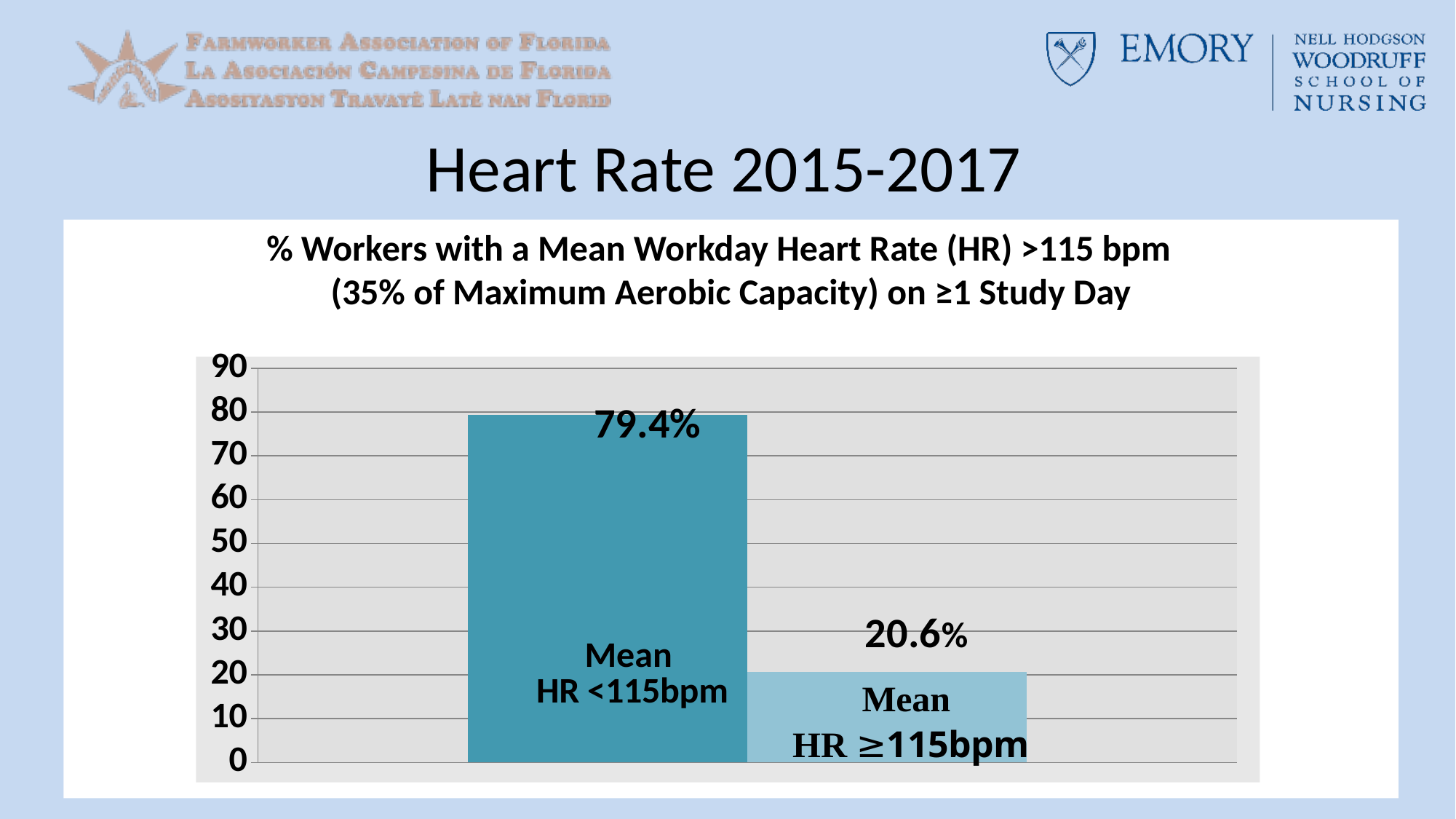
How many bars are shown in the chart? 2 What is the difference between the Mean HR <115bpm and Mean HR ≥115bpm values? 58.8% What is the title of the chart? % Workers with a Mean Workday Heart Rate (HR) >115 bpm (35% of Maximum Aerobic Capacity) on ≥1 Study Day What percentage of workers had a mean HR <115bpm? 79.4% Which category has the higher value? Mean HR <115bpm Which category has the lower value? Mean HR ≥115bpm Is the value for Mean HR ≥115bpm greater or less than 30? less Is the value for Mean HR <115bpm larger or smaller than the value for Mean HR ≥115bpm? larger What is the highest value shown on the vertical axis? 90 What type of chart is shown on the slide? bar chart What percentage of workers had a mean HR ≥115bpm? 20.6% Is the value for Mean HR <115bpm greater or less than 70? greater